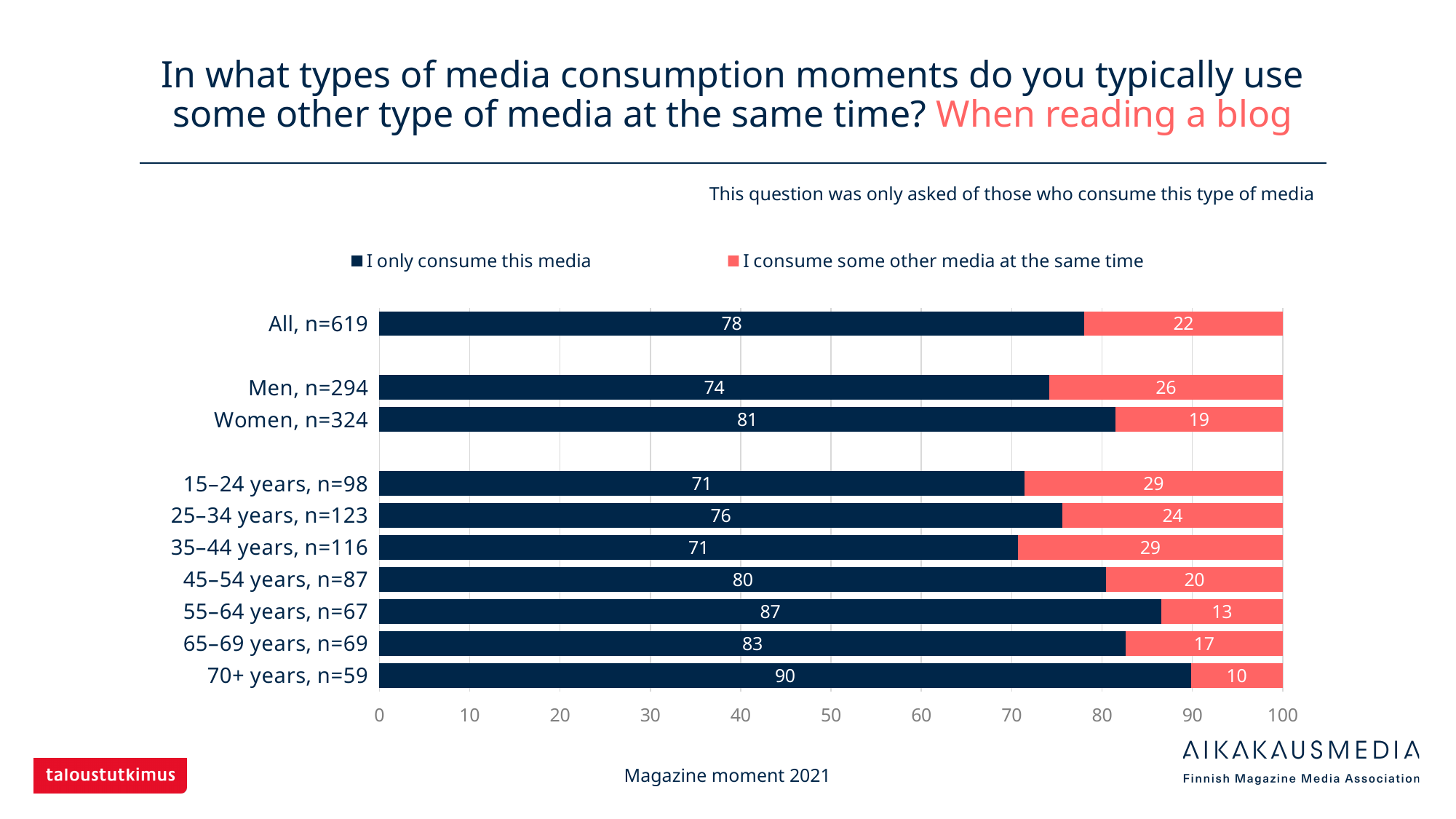
Which category has the lowest value for "I consume some other media at the same time"? 70+ years, n=59 What kind of chart is shown on the slide? Stacked bar chart What is the value of "I only consume this media" for All, n=619? 78 Which category has the highest value for "I only consume this media"? 70+ years, n=59 How many series does the legend list? 2 How many categories are shown on the chart? 10 What is the value of "I only consume this media" for 55–64 years, n=67? 87 What is the total of the stacked bar for 65–69 years, n=69? 100 What is the difference between the "I only consume this media" values for Women, n=324 and Men, n=294? 7 Which has a larger "I consume some other media at the same time" value: 15–24 years, n=98 or 45–54 years, n=87? 15–24 years, n=98 What is the value of "I consume some other media at the same time" for Men, n=294? 26 Which colour represents "I consume some other media at the same time" in the legend? Red (coral)